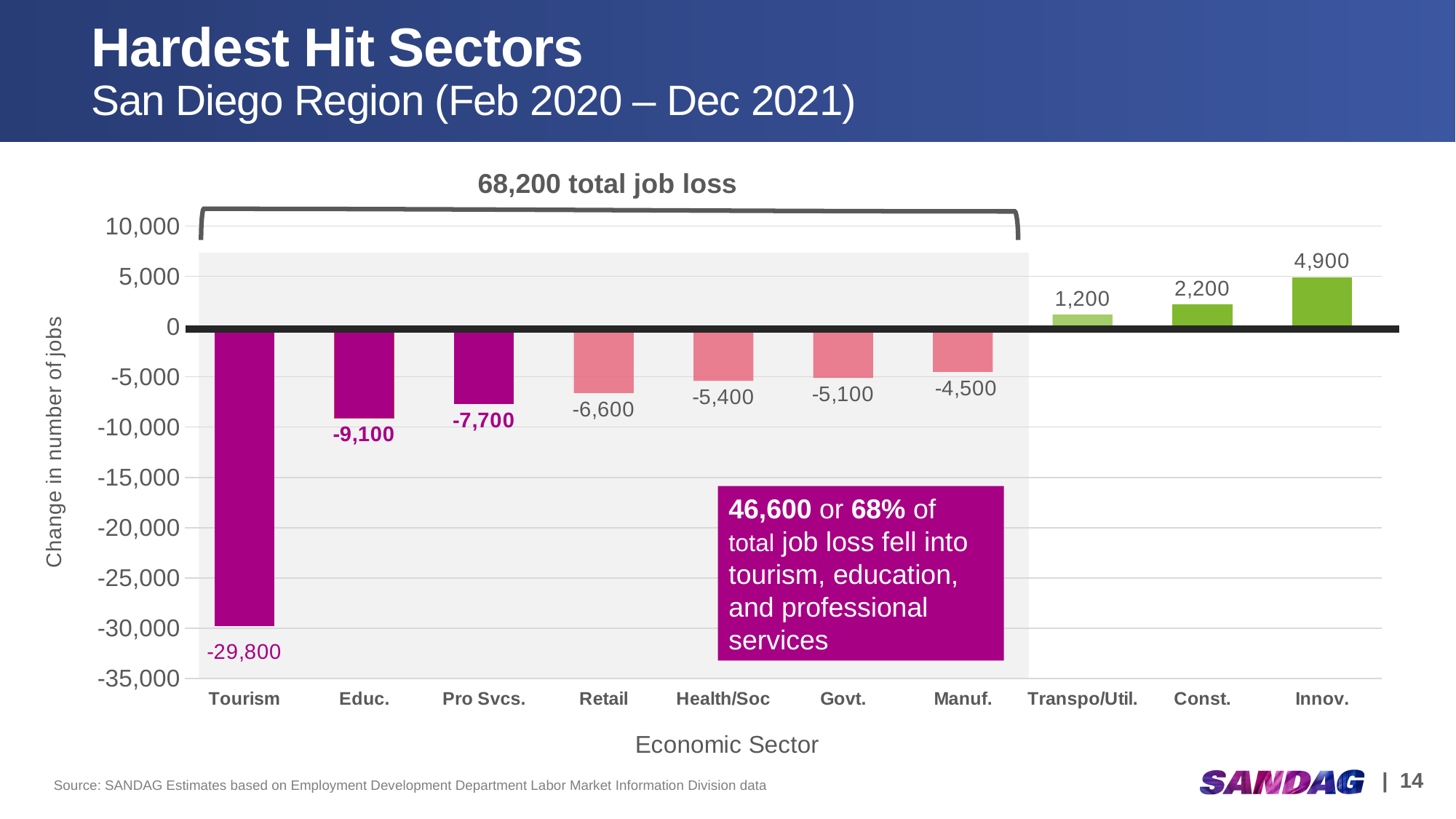
Which economic sector has the largest job gain? Innov. What kind of chart is shown on the slide? Bar chart What is the difference between the job change for Retail and Manuf.? 2,100 What total job loss is labelled above the bracket on the chart? 68,200 total job loss What is the change in number of jobs for Tourism? -29,800 What is the change in number of jobs for Innov.? 4,900 How many economic sectors are shown on the x axis? 10 What is the change in number of jobs for Health/Soc? -5,400 What is the change in number of jobs for Educ.? -9,100 Which sector lost more jobs, Pro Svcs. or Govt.? Pro Svcs. What is the label of the y axis? Change in number of jobs Which economic sector has the largest job loss? Tourism